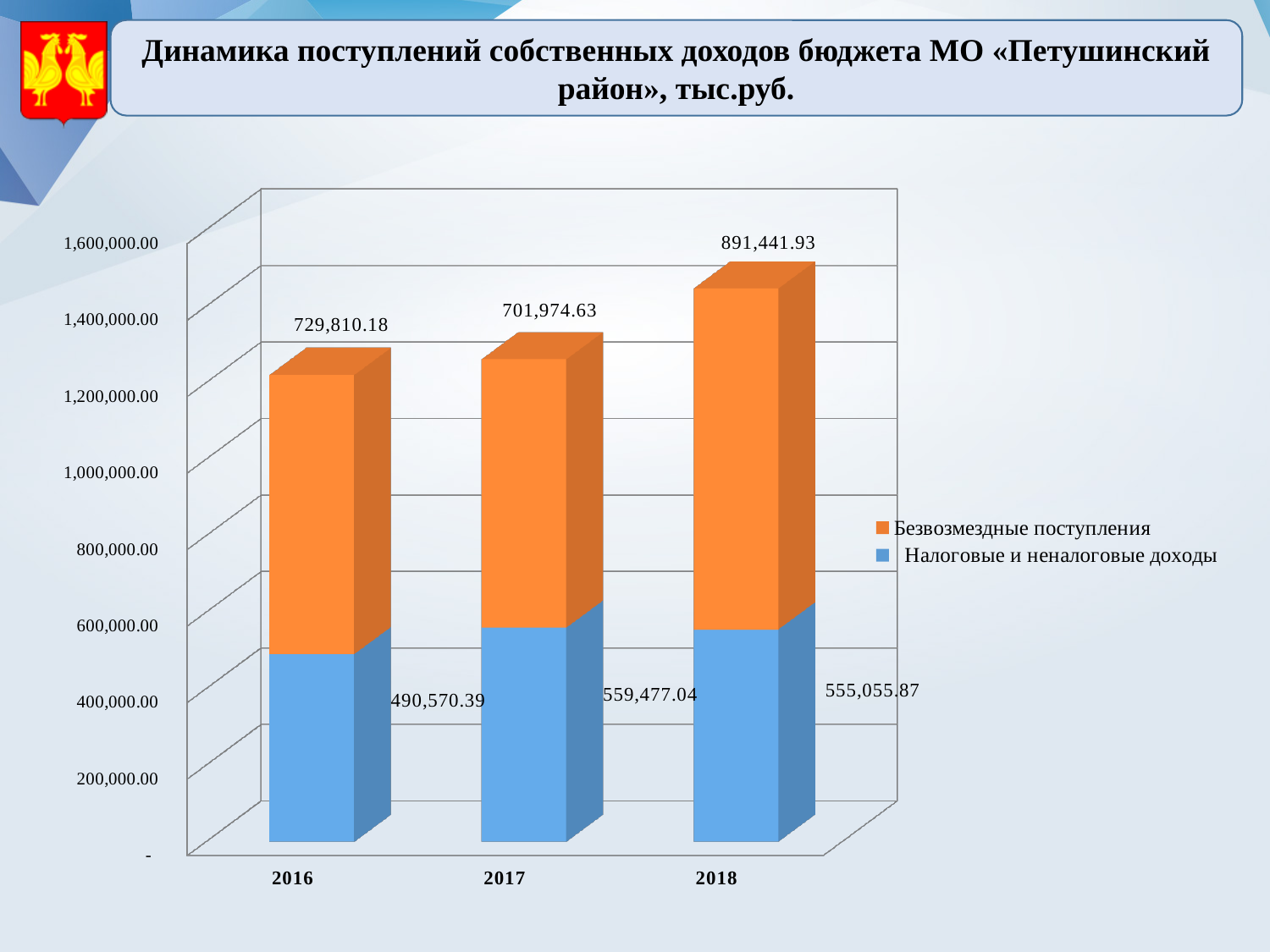
In which year is Безвозмездные поступления highest? 2018 What is the difference between Безвозмездные поступления in 2018 and in 2017? 189,467.30 How many series does the legend list? 2 What is the total of the stacked bar for 2018? 1,446,497.80 In which year is Налоговые и неналоговые доходы lowest? 2016 What kind of chart is shown on the slide? Stacked bar chart What is the value of Безвозмездные поступления for 2017? 701,974.63 How many years are shown on the x axis? 3 Which is larger: Налоговые и неналоговые доходы in 2017 or in 2018? 2017 What is the value of Безвозмездные поступления for 2018? 891,441.93 What is the value of Налоговые и неналоговые доходы for 2016? 490,570.39 What is the total of the stacked bar for 2016? 1,220,380.57